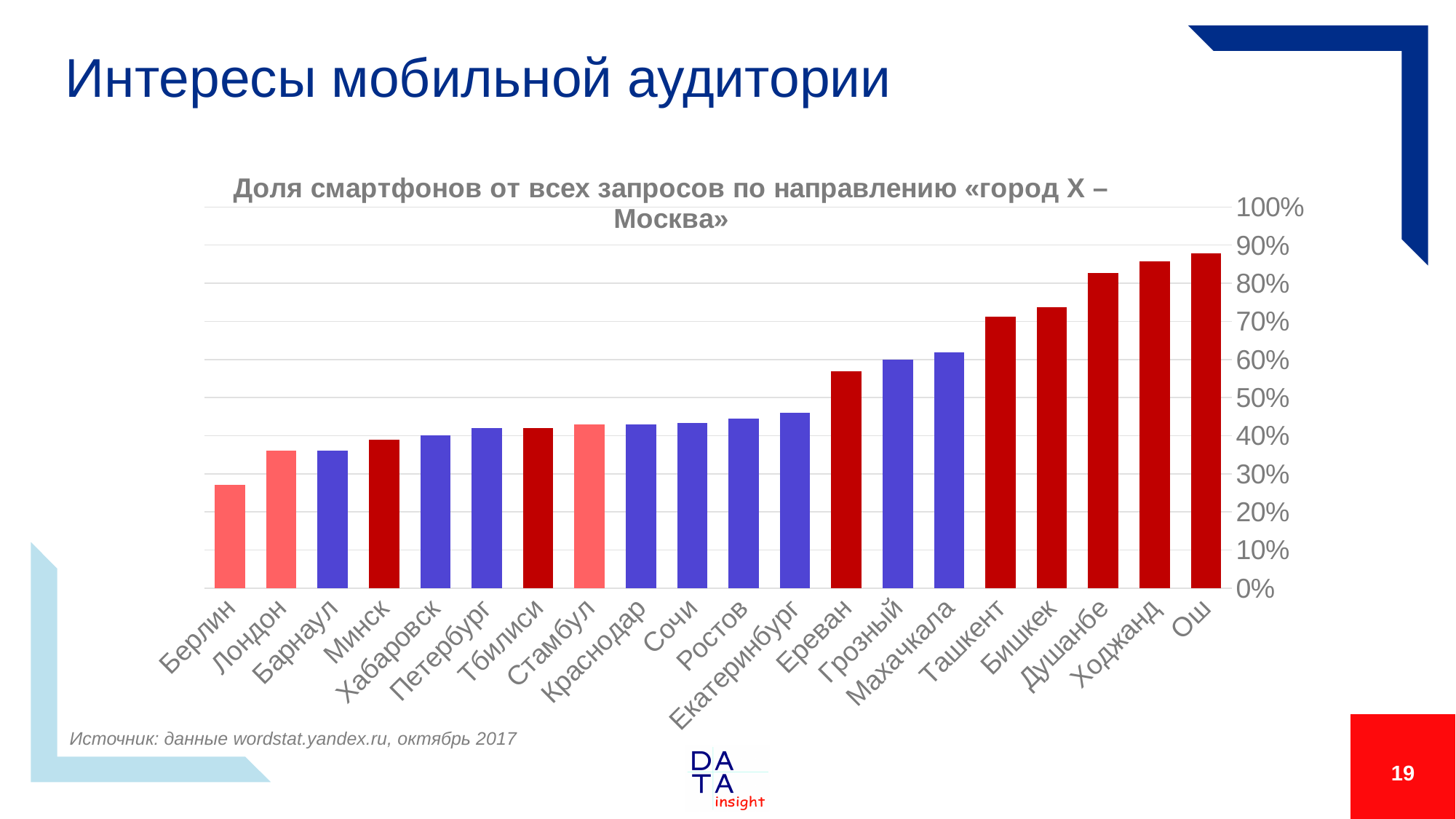
What is the title of the chart? Доля смартфонов от всех запросов по направлению «город X – Москва» Which city has the lowest share of smartphone queries in the chart? Берлин Which city has the highest share of smartphone queries in the chart? Ош Is the value for Екатеринбург greater or less than 50%? less Which has the larger value, Лондон or Махачкала? Махачкала Is the value for Ереван greater or less than 50%? greater Do the bar values rise or fall from left to right along the x axis? rise Is the value for Ош greater or less than 80%? greater Which has the larger value, Душанбе or Ташкент? Душанбе How many cities are shown on the x axis of the chart? 20 What kind of chart is shown on the slide? bar chart